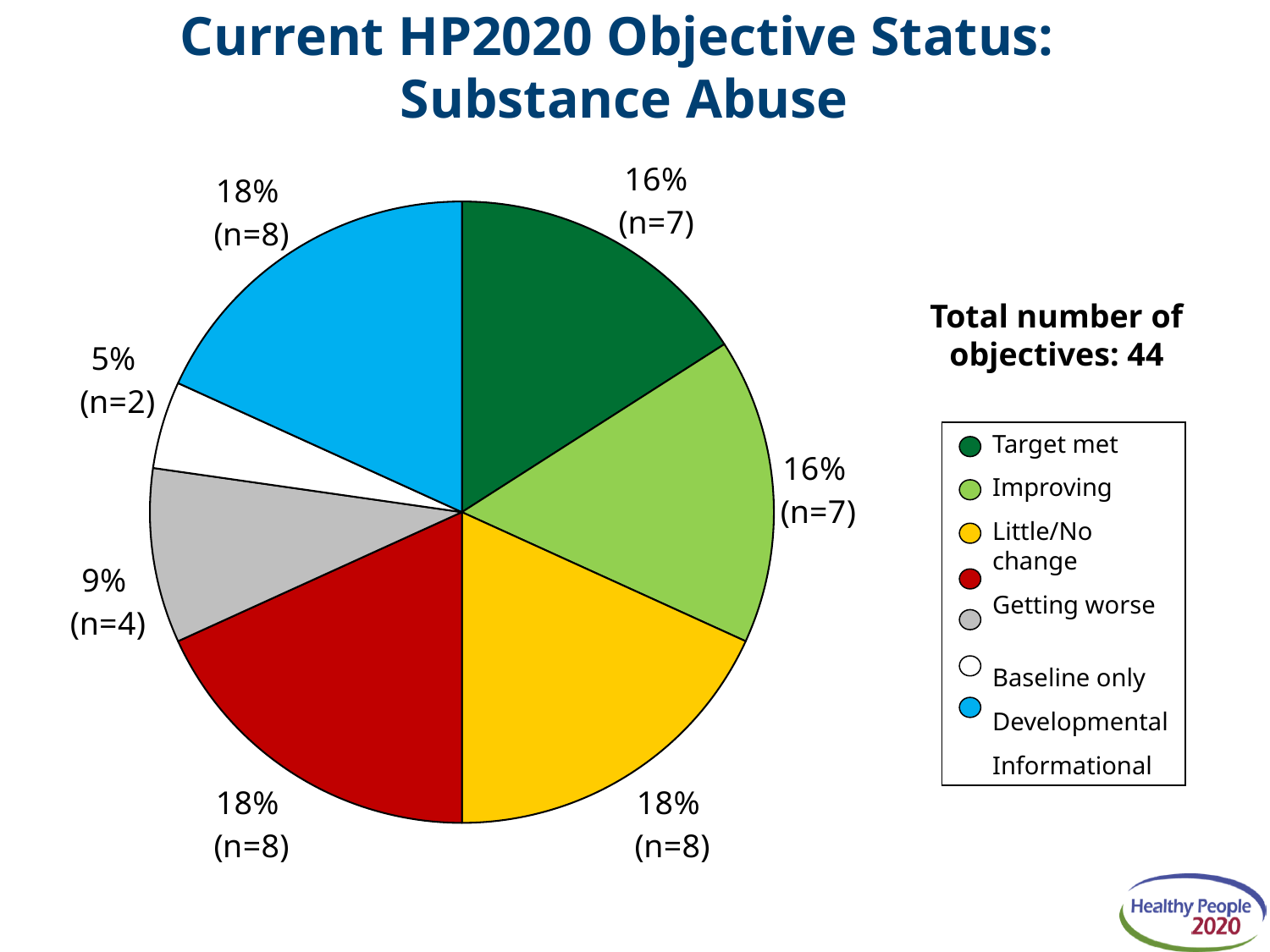
What percentage of objectives are in the Target met category? 16% How many objectives are in the Getting worse category? n=8 What percentage of objectives are in the Baseline only category? 9% How many objectives are in the Improving category? n=7 What percentage of objectives are in the Little/No change category? 18% How many categories does the legend list? 7 Which category has more objectives, Baseline only or Developmental? Baseline only What is the difference in percentage points between the Informational and Baseline only slices? 9 What kind of chart is shown on the slide? pie chart What is the total number of objectives stated on the slide? 44 Which category has the smallest share of the pie? Developmental How many slices does the pie chart have? 7